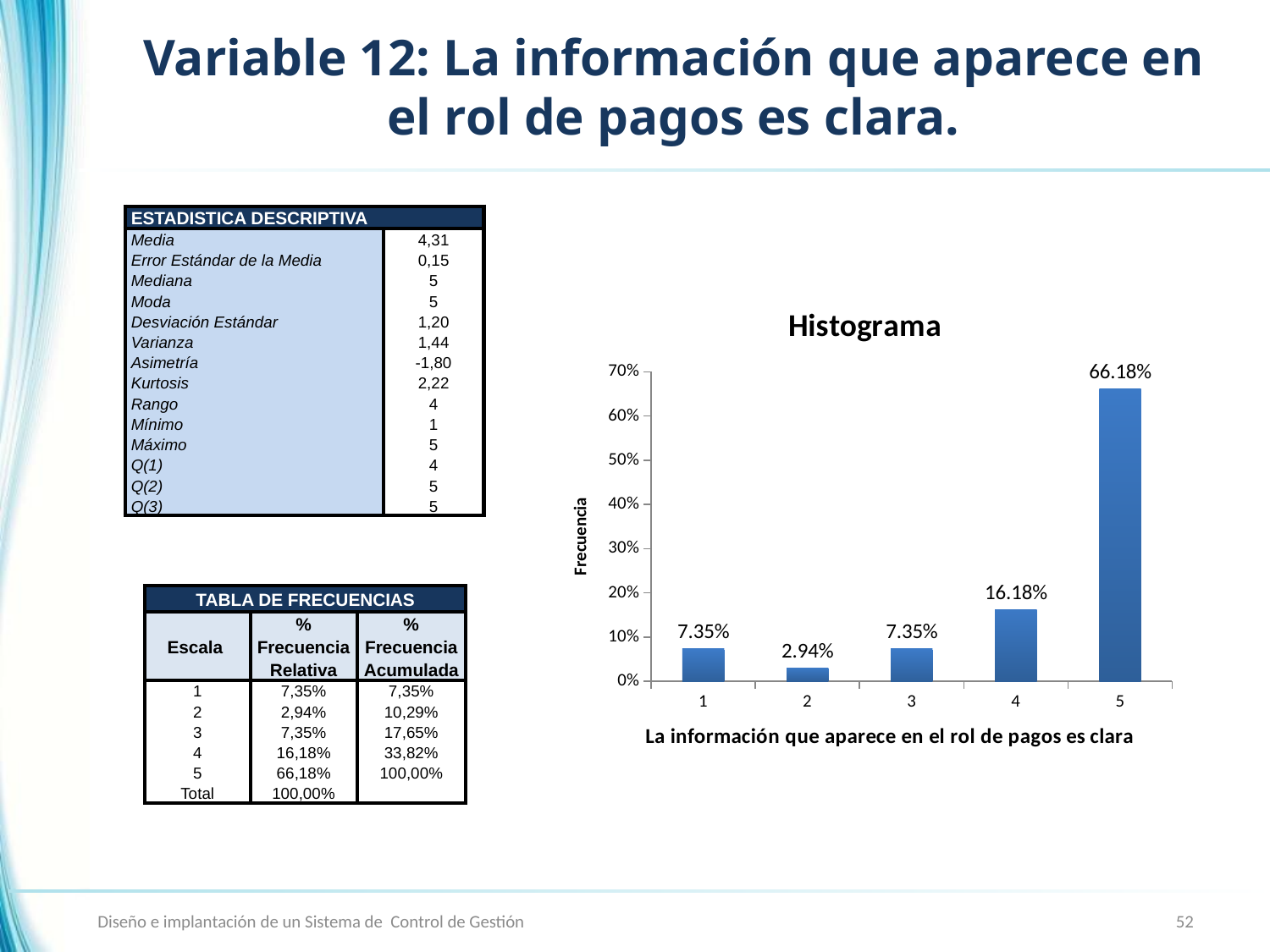
Which is larger in the Histograma chart, the value for category 4 or the value for category 3? category 4 What kind of chart is the Histograma chart? bar chart Which category has the highest value in the Histograma chart? 5 What is the difference between the values for category 5 and category 4 in the Histograma chart? 50.00% Which category has the lowest value in the Histograma chart? 2 Is the value for category 5 in the Histograma chart greater or less than 60%? greater What is the difference between the values for category 4 and category 2 in the Histograma chart? 13.24% What is the value for category 5 in the Histograma chart? 66.18% What is the value for category 2 in the Histograma chart? 2.94% What is the y-axis label of the Histograma chart? Frecuencia What is the value for category 4 in the Histograma chart? 16.18% How many categories are shown on the x axis of the Histograma chart? 5